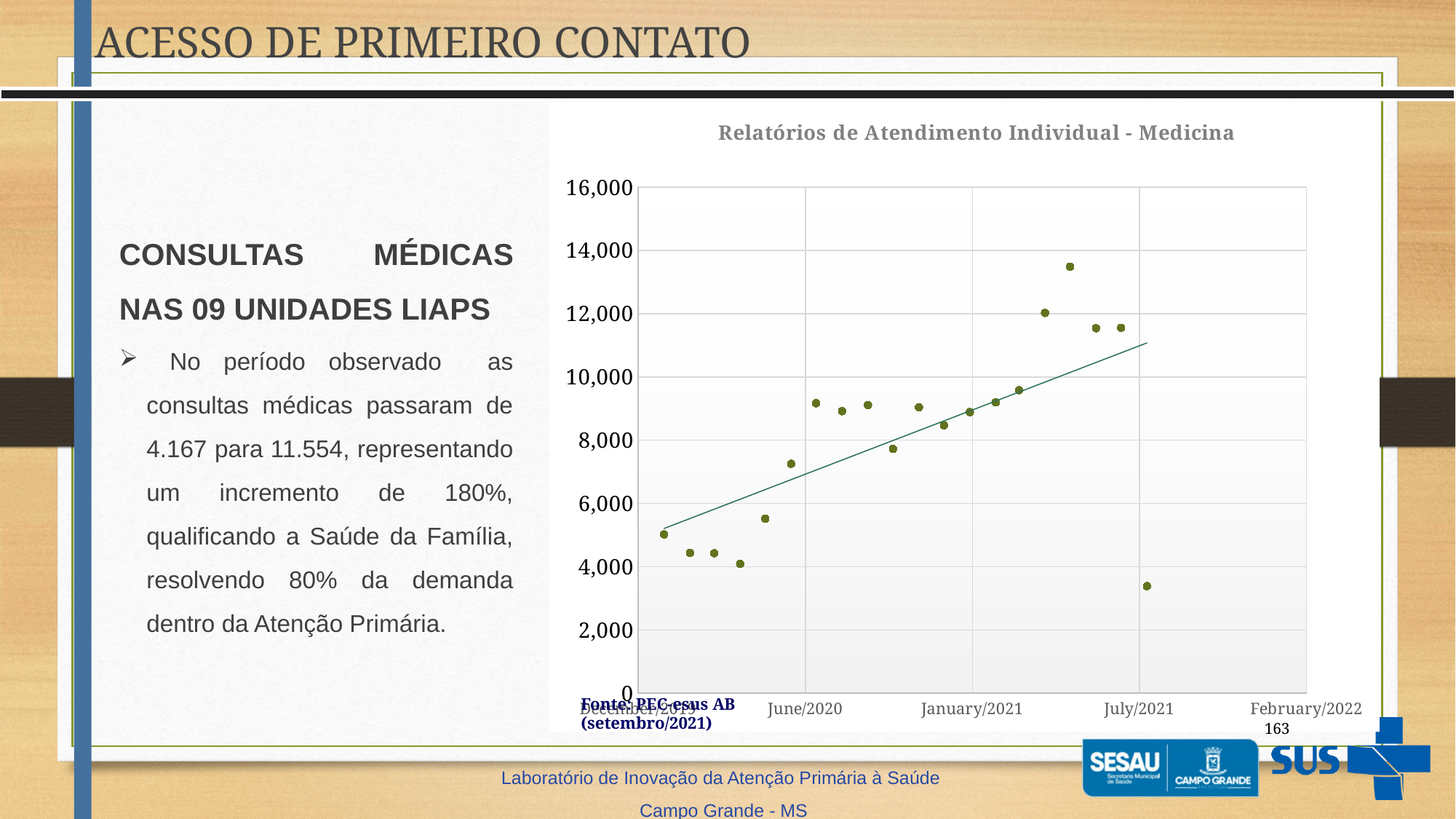
Which is larger: the highest plotted point or the leftmost plotted point? the highest plotted point What is the maximum value shown on the y axis of the chart? 16,000 Is the value of the leftmost plotted point greater or less than 6,000? less What kind of chart is shown on the slide? scatter chart Is the highest plotted value in the chart greater or less than 14,000? less How many data points are plotted in the chart? 20 What is the title of the chart? Relatórios de Atendimento Individual - Medicina Do the plotted values generally rise or fall along the x axis according to the trend line? rise Is the value of the leftmost plotted point greater or less than 4,000? greater